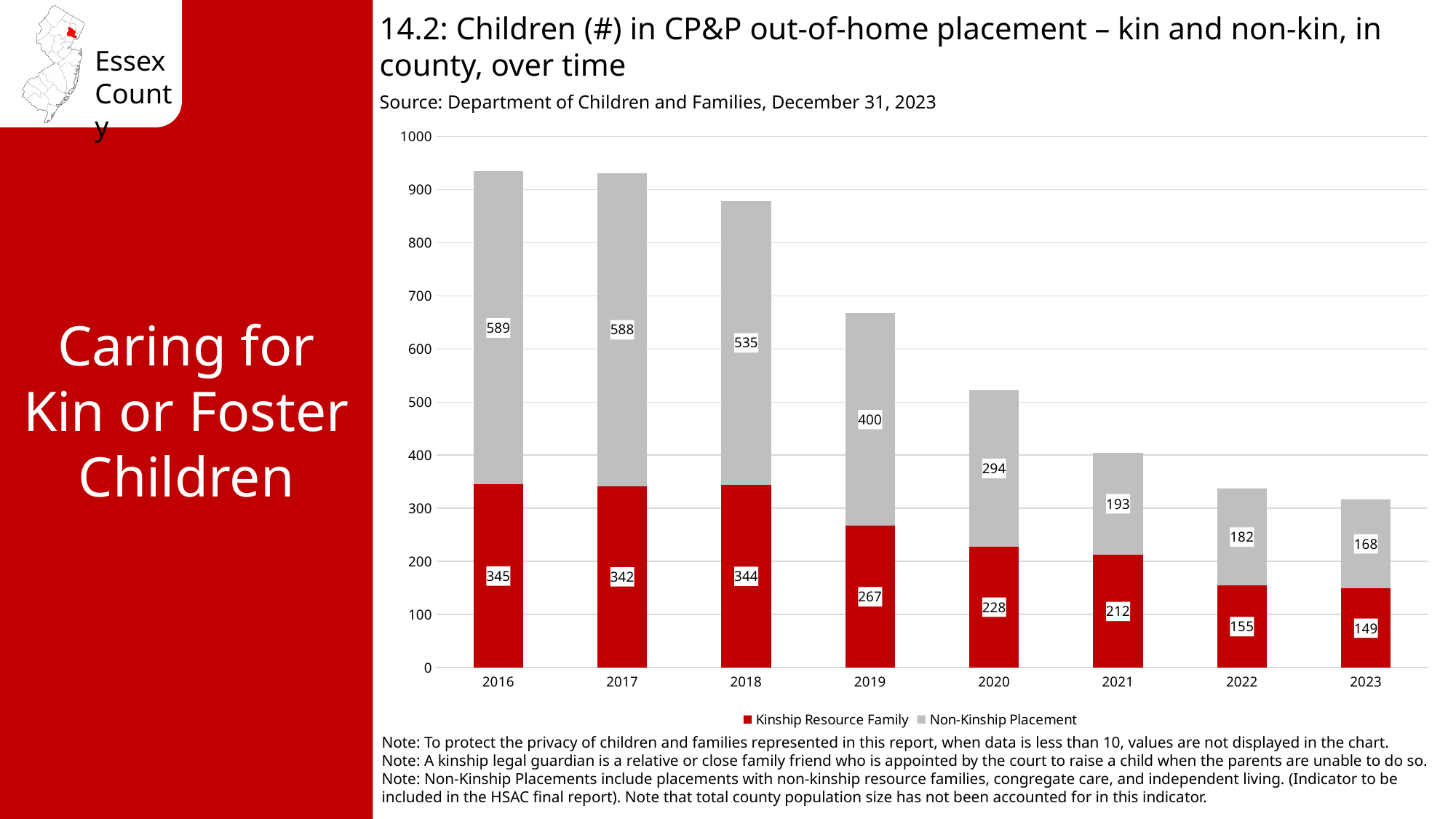
Which is larger in 2020: Kinship Resource Family or Non-Kinship Placement? Non-Kinship Placement What is the Kinship Resource Family value for 2019? 267 What is the difference between the Non-Kinship Placement values for 2018 and 2019? 135 Which year has the lowest Kinship Resource Family value? 2023 What is the Non-Kinship Placement value for 2021? 193 How many series does the legend list? 2 What is the total number of children in out-of-home placement in 2016 (both series combined)? 934 Which year has the highest Non-Kinship Placement value? 2016 What kind of chart is shown? Stacked bar chart Do the Non-Kinship Placement values rise or fall from 2016 to 2023? Fall What is the total number of children in out-of-home placement in 2022 (both series combined)? 337 How many years are shown on the x axis? 8